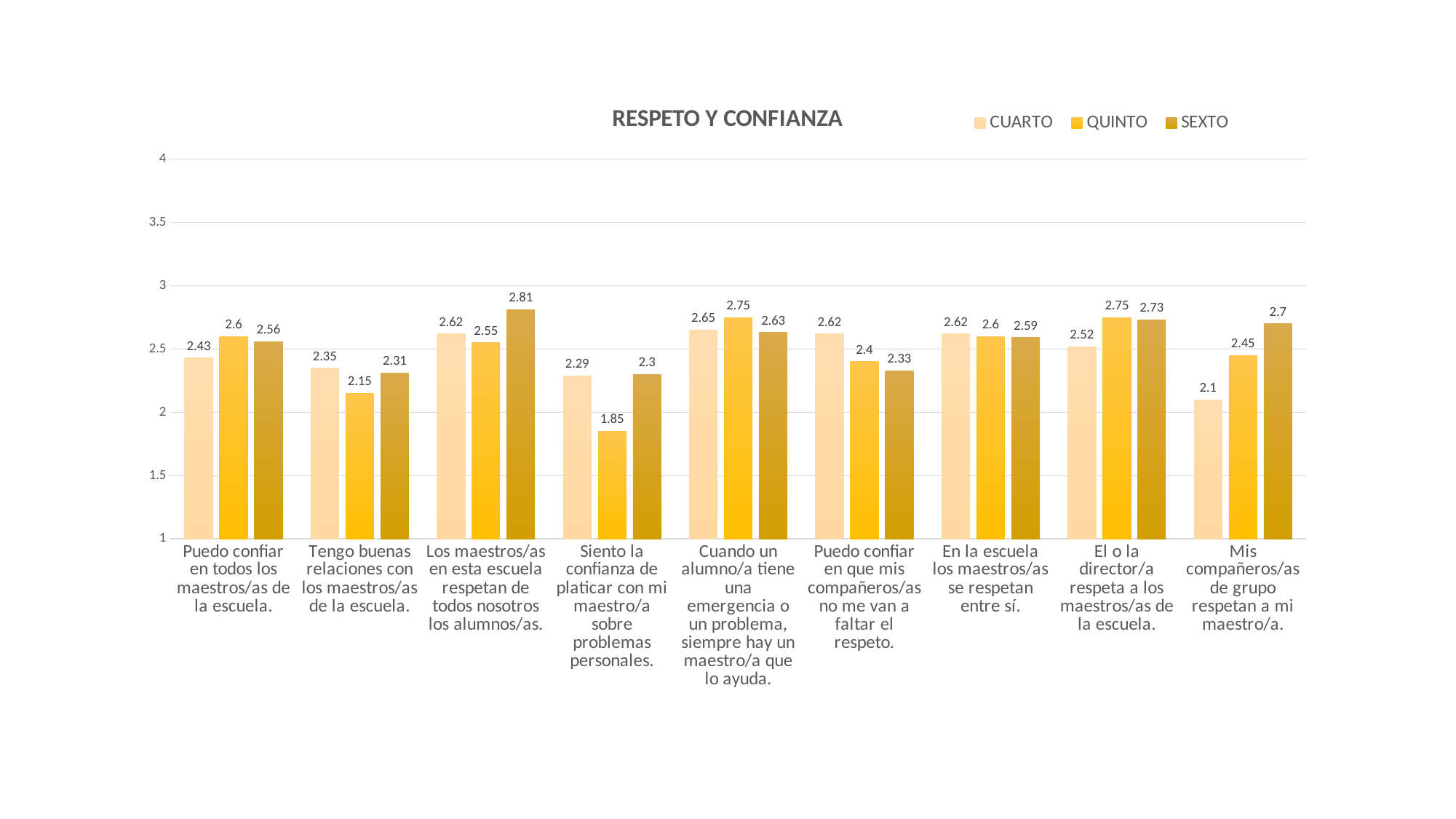
How many categories are shown on the x axis? 9 Which category has the highest SEXTO value? Los maestros/as en esta escuela respetan de todos nosotros los alumnos/as. For "Tengo buenas relaciones con los maestros/as de la escuela.", which is larger: the CUARTO value or the QUINTO value? CUARTO How many series does the legend list? 3 What is the QUINTO value for "Siento la confianza de platicar con mi maestro/a sobre problemas personales."? 1.85 What is the difference between the SEXTO and QUINTO values for "Siento la confianza de platicar con mi maestro/a sobre problemas personales."? 0.45 What kind of chart is shown on the slide? Bar chart What is the CUARTO value for "Mis compañeros/as de grupo respetan a mi maestro/a."? 2.1 What is the title of the chart? RESPETO Y CONFIANZA Is the QUINTO value for "Cuando un alumno/a tiene una emergencia o un problema, siempre hay un maestro/a que lo ayuda." greater or less than 2.5? greater What is the SEXTO value for "Los maestros/as en esta escuela respetan de todos nosotros los alumnos/as."? 2.81 Which category has the lowest QUINTO value? Siento la confianza de platicar con mi maestro/a sobre problemas personales.